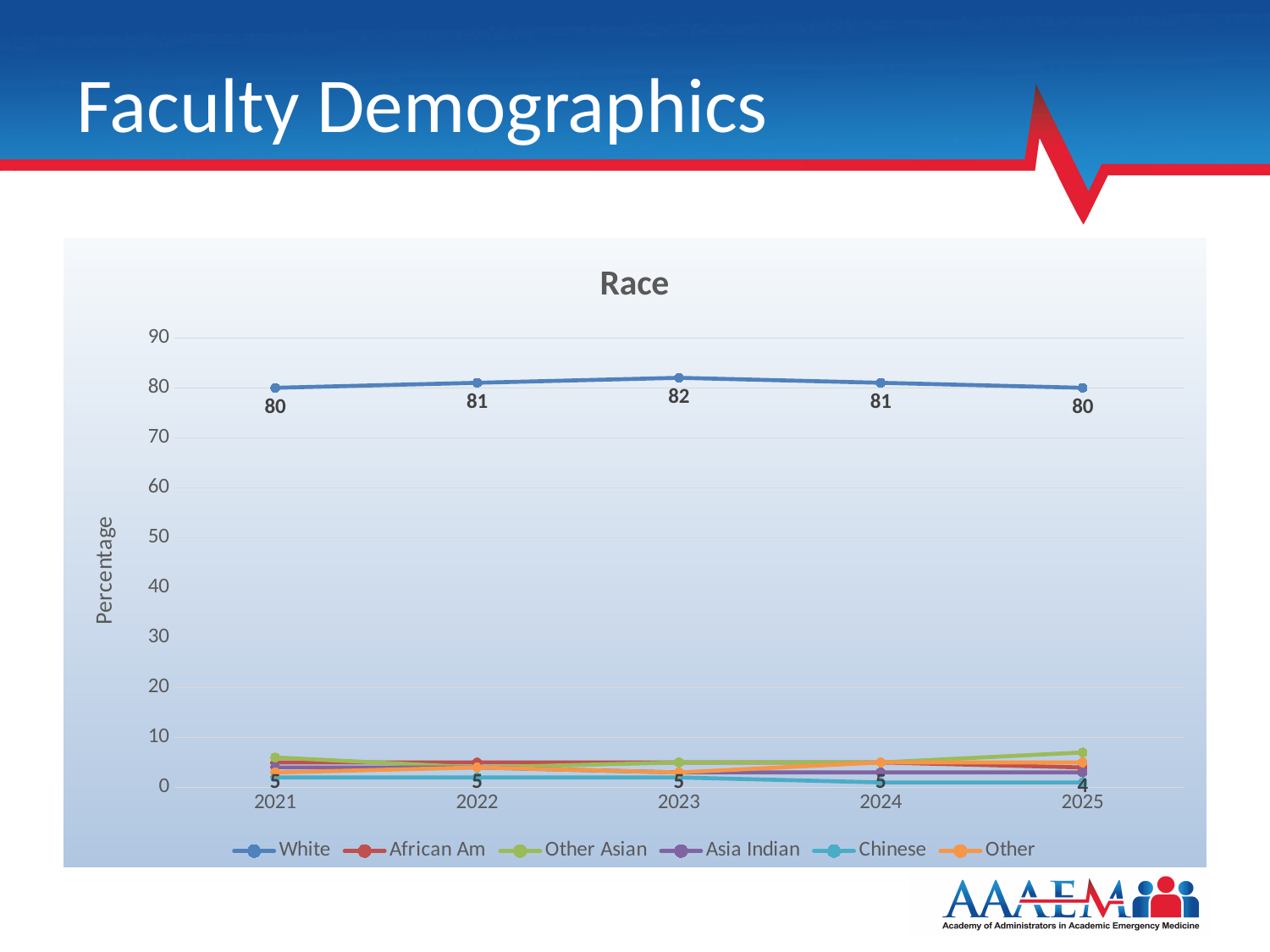
What is the value for White in 2023? 82 Which series is larger in 2023, White or Other Asian? White How many series does the legend list? 6 Is the value for Chinese in 2024 greater or less than 10? less How many years are shown on the x axis? 5 Is the value for White in 2022 greater or less than 50? greater What is the title of the chart? Race What is the difference between the White value in 2023 and the White value in 2025? 2 What is the value for White in 2021? 80 In which year is the White series highest? 2023 What is the value for White in 2024? 81 What type of chart is shown on the slide? line chart